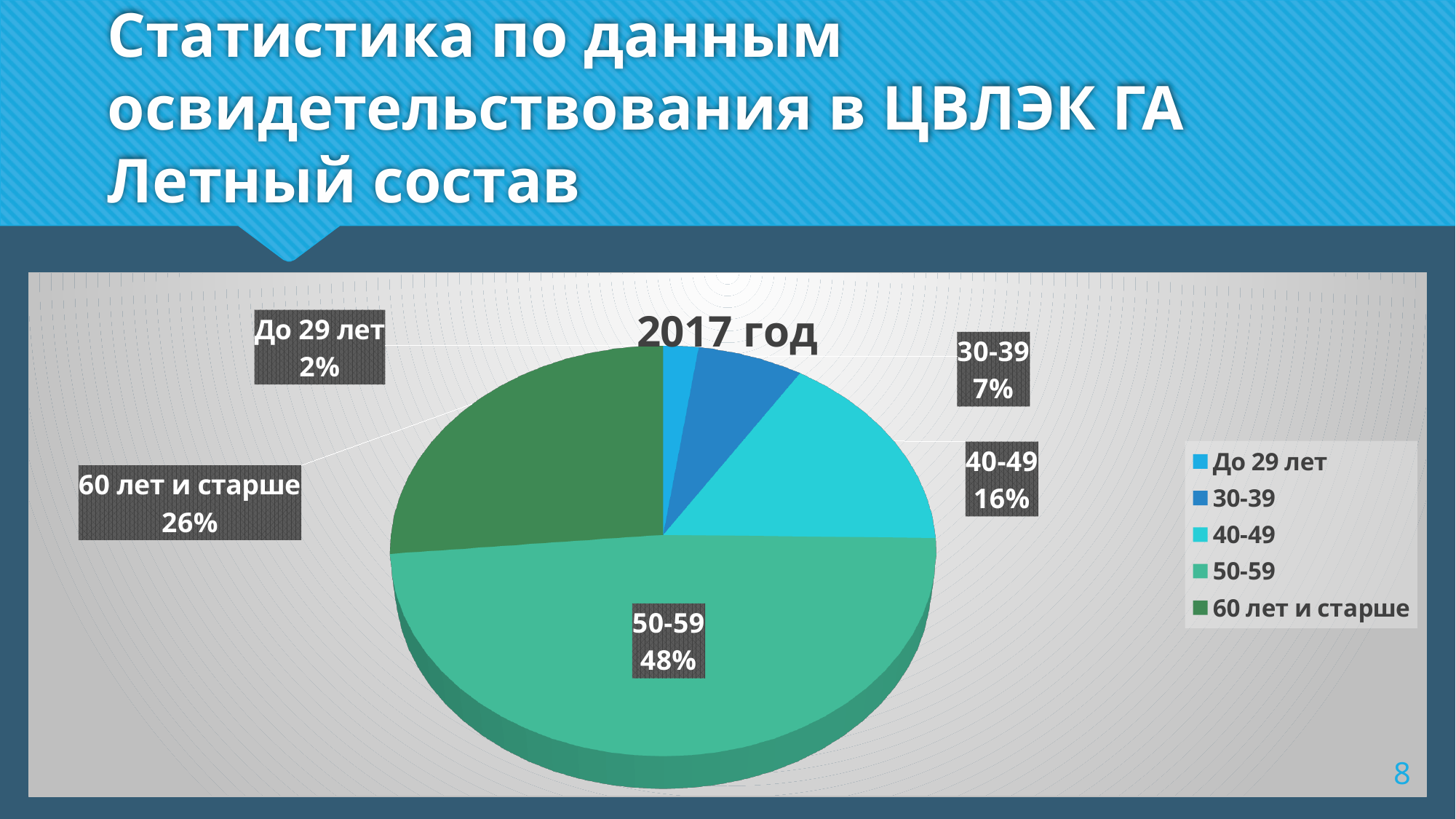
How many slices does the pie chart have? 5 Which slice is larger, 40-49 or 30-39? 40-49 What is the difference in percentage points between the 50-59 and 60 лет и старше slices? 22 What kind of chart is shown on the slide? Pie chart What percentage is shown for the 30-39 age group? 7% What is the title of the chart? 2017 год What is the value shown for the 60 лет и старше slice? 26% What share of the pie does the 50-59 age group have? 48% What percentage is shown for the 40-49 age group? 16% Which age group has the largest share of the pie? 50-59 What percentage is shown for the До 29 лет group? 2% Which age group has the smallest share of the pie? До 29 лет